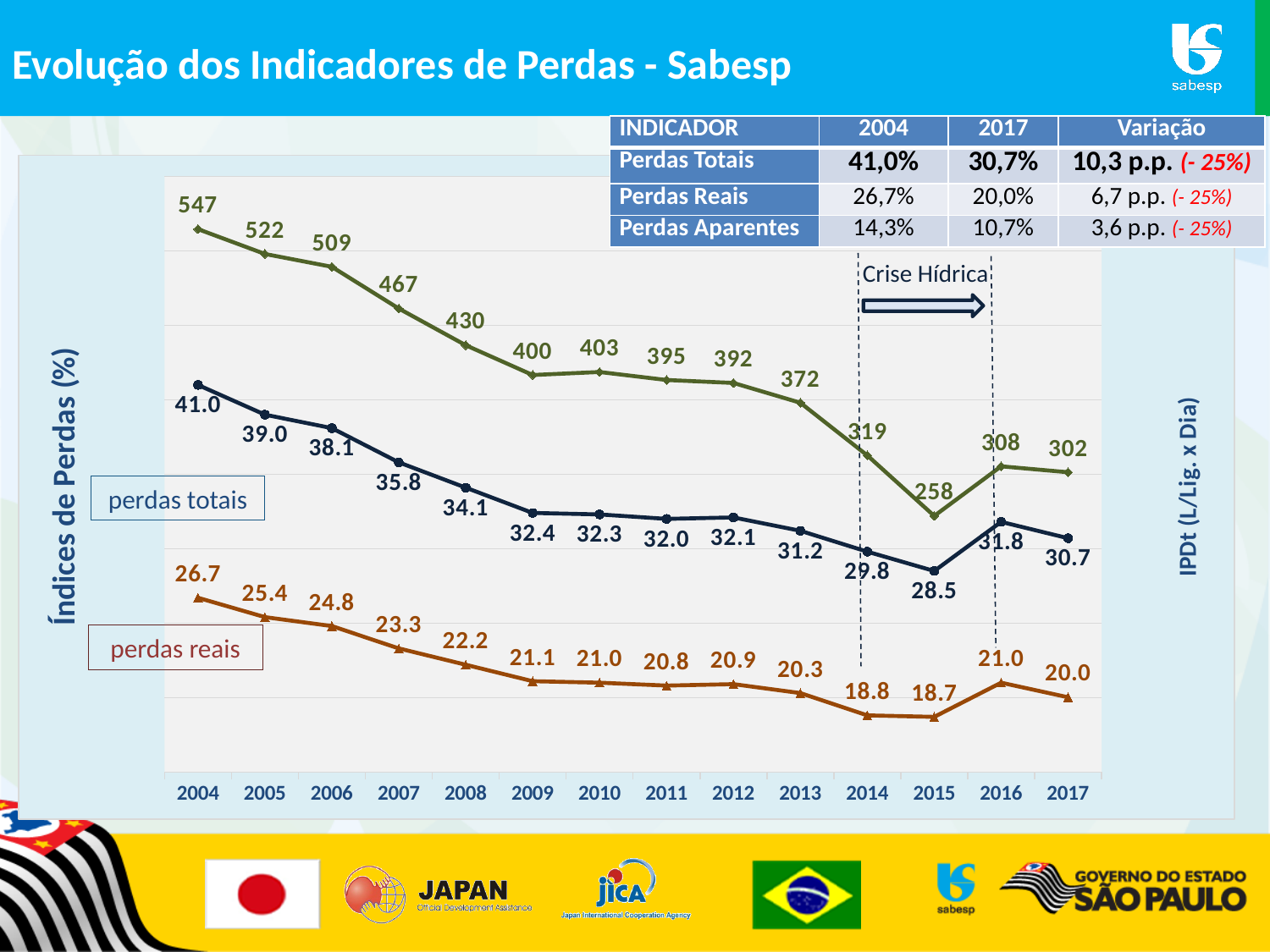
Overall, do the perdas totais values rise or fall from 2004 to 2017? fall What is the value of perdas reais in 2017? 20.0 In which year is perdas totais at its highest? 2004 What is the value of perdas totais in 2004? 41.0 What type of chart is shown on the slide? line chart In which year is the IPDt series at its lowest? 2015 Which is larger, perdas totais in 2016 or perdas totais in 2017? 2016 What is the difference between perdas reais in 2004 and 2015? 8.0 What is the IPDt value in 2015? 258 How many years are plotted on the x axis? 14 What is the difference between the IPDt values in 2004 and 2017? 245 What is the label of the right-hand vertical axis? IPDt (L/Lig. x Dia)